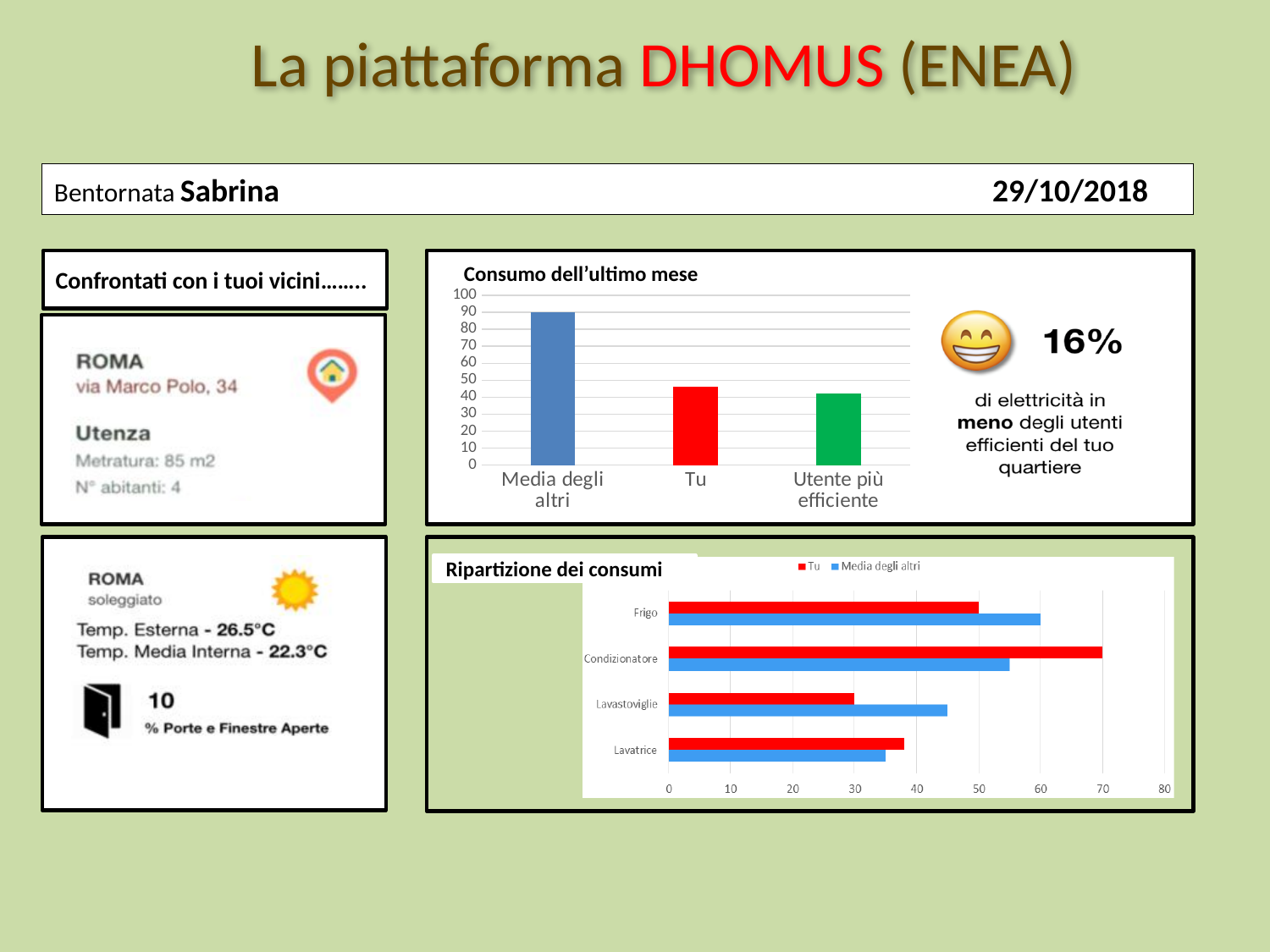
How many series does the legend of the 'Ripartizione dei consumi' chart list? 2 In the 'Ripartizione dei consumi' chart, which category has the highest value for the 'Tu' series? Condizionatore In the 'Ripartizione dei consumi' chart, is the 'Media degli altri' value for 'Lavastoviglie' greater or less than 40? greater What kind of chart is 'Ripartizione dei consumi'? bar chart In the 'Consumo dell'ultimo mese' chart, which category has the highest value? Media degli altri In the 'Ripartizione dei consumi' chart, for 'Frigo', which is larger, 'Tu' or 'Media degli altri'? Media degli altri In the 'Ripartizione dei consumi' chart, which category has the lowest value for the 'Tu' series? Lavastoviglie In the 'Consumo dell'ultimo mese' chart, which is larger, 'Tu' or 'Media degli altri'? Media degli altri In the 'Consumo dell'ultimo mese' chart, is the value for 'Utente più efficiente' greater or less than 40? greater In the 'Consumo dell'ultimo mese' chart, what is the value for 'Media degli altri'? 90 How many categories are shown in the 'Consumo dell'ultimo mese' chart? 3 In the 'Consumo dell'ultimo mese' chart, is the value for 'Tu' greater or less than 50? less